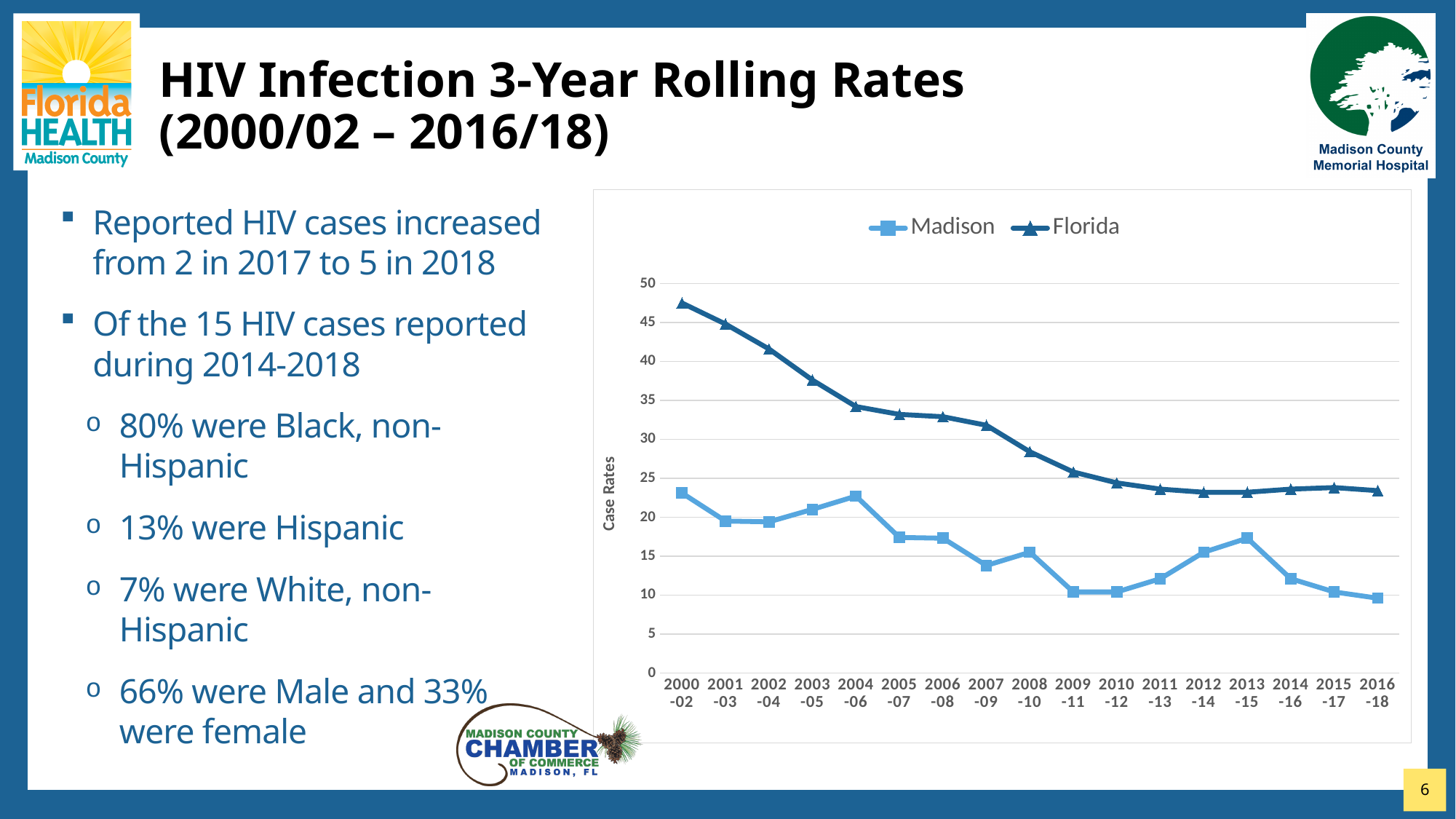
Is the Madison value for 2013-15 greater or less than 15? greater What kind of chart is shown on the slide? line chart Is the Madison value for 2009-11 greater or less than 15? less In which period does the Florida series reach its highest value? 2000-02 How many time periods are plotted along the x axis of the chart? 17 What is the label on the vertical axis of the chart? Case Rates Is the Florida value for 2016-18 greater or less than 25? less Does the Florida series generally rise or fall from 2000-02 to 2016-18? fall How many series does the chart legend list? 2 Which series has the highest value in 2000-02? Florida